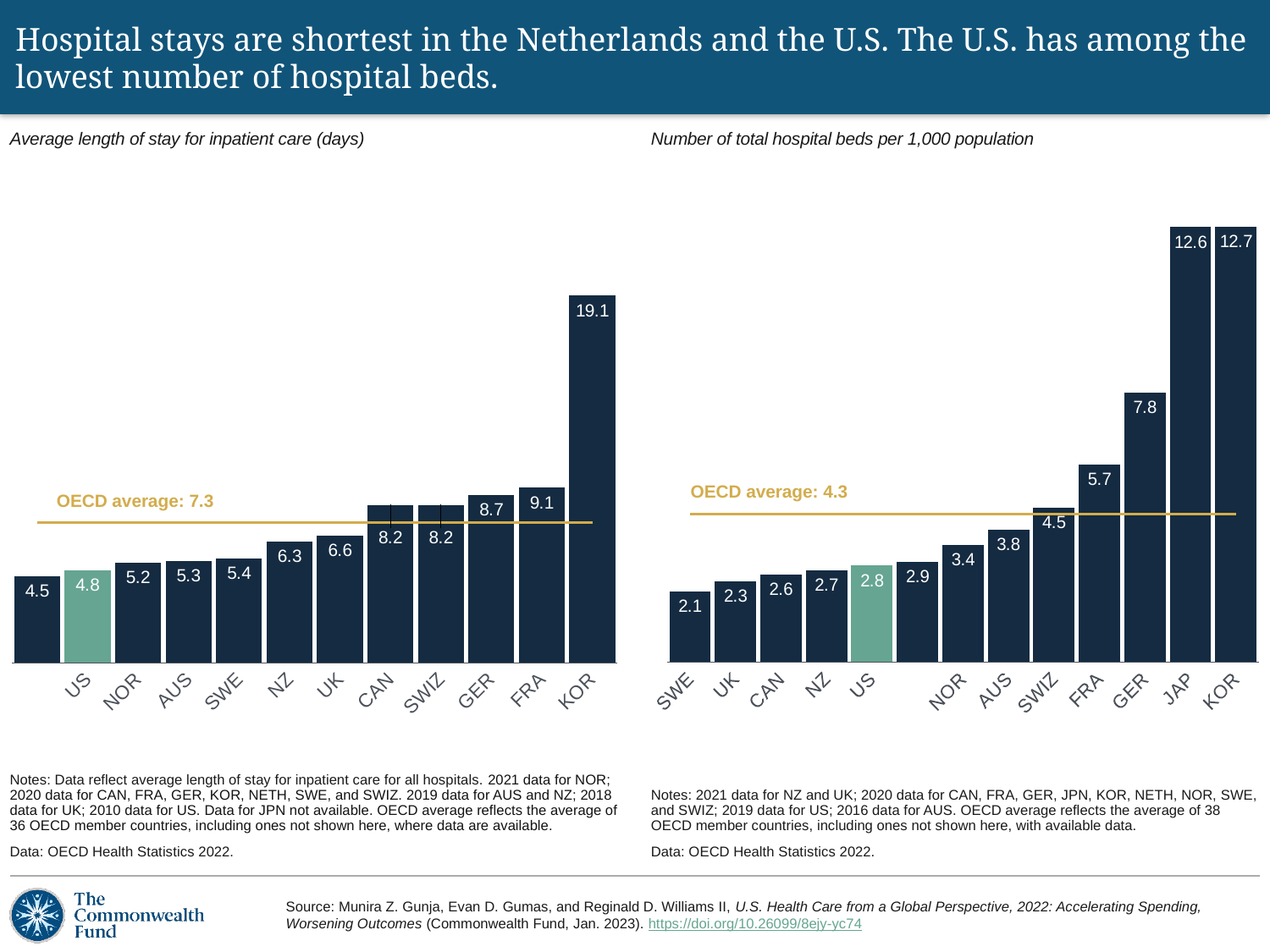
In the 'Number of total hospital beds per 1,000 population' chart, which labeled country has the lowest value? SWE In the 'Average length of stay for inpatient care (days)' chart, which labeled country has the highest value? KOR In the 'Average length of stay for inpatient care (days)' chart, what OECD average is shown? 7.3 What type of chart is used for 'Average length of stay for inpatient care (days)'? Bar chart In the 'Average length of stay for inpatient care (days)' chart, what is the value for the US? 4.8 In the 'Number of total hospital beds per 1,000 population' chart, what is the difference between KOR and JAP? 0.1 In the 'Number of total hospital beds per 1,000 population' chart, which is larger, the value for FRA or the value for SWIZ? FRA How many bars are plotted in the 'Number of total hospital beds per 1,000 population' chart? 13 In the 'Number of total hospital beds per 1,000 population' chart, what is the value for GER? 7.8 In the 'Average length of stay for inpatient care (days)' chart, what is the value for KOR? 19.1 In the 'Number of total hospital beds per 1,000 population' chart, what is the value for the US? 2.8 In the 'Average length of stay for inpatient care (days)' chart, what is the difference between FRA and GER? 0.4